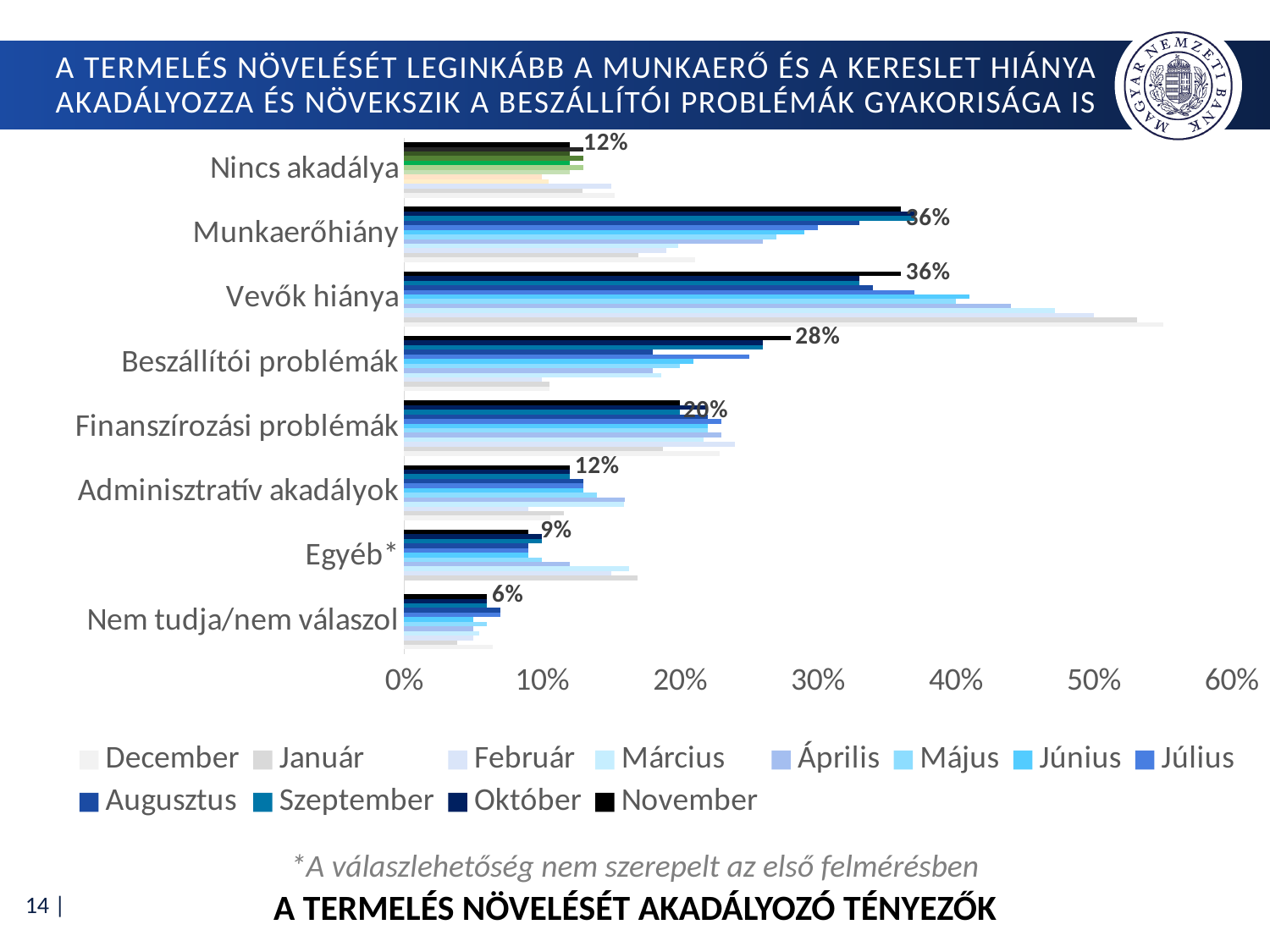
How many series does the legend list? 12 Which category has the lowest November value? Nem tudja/nem válaszol What is the November value for Nem tudja/nem válaszol? 6% What type of chart is shown? bar chart What is the November value for Munkaerőhiány? 36% What is the November value for Egyéb*? 9% What is the November value for Beszállítói problémák? 28% What is the November value for Adminisztratív akadályok? 12% What is the difference between the November values for Munkaerőhiány and Beszállítói problémák? 8% Which has a larger November value, Beszállítói problémák or Adminisztratív akadályok? Beszállítói problémák Is the December value for Vevők hiánya greater or less than 50%? greater How many categories are shown on the y axis? 8